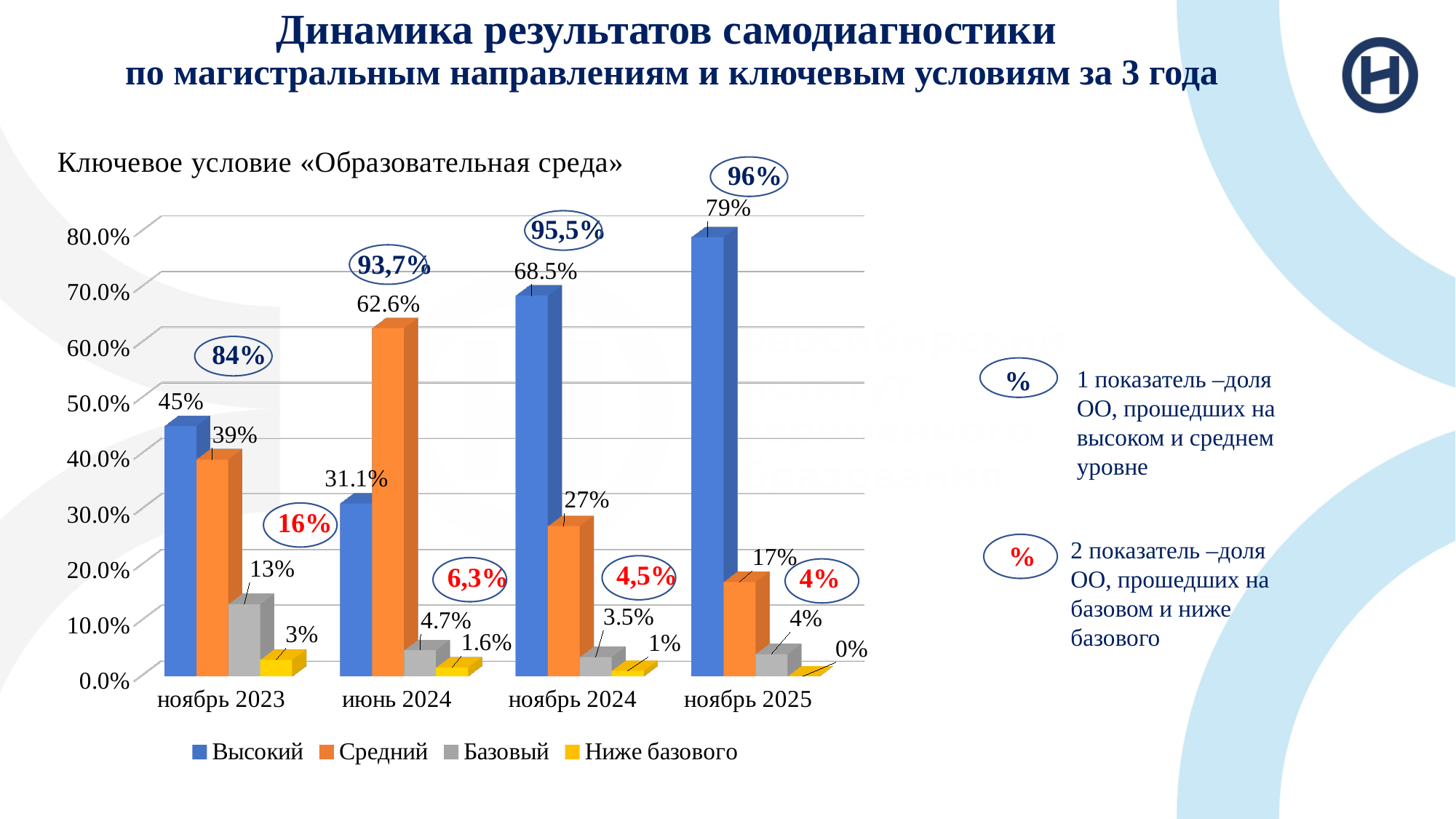
What is the value for Базовый in ноябрь 2023? 13% What is the difference between the Высокий values for ноябрь 2025 and ноябрь 2024? 10.5% How many periods are shown on the x axis? 4 What kind of chart is shown on the slide? Bar chart What is the value for Ниже базового in ноябрь 2024? 1% How many series does the legend list? 4 In which period is the Высокий value the highest? ноябрь 2025 What is the value for Средний in июнь 2024? 62.6% Does the Средний value rise or fall from июнь 2024 to ноябрь 2025? Fall In which period is the Ниже базового value the lowest? ноябрь 2025 Which is larger in июнь 2024: Высокий or Средний? Средний What is the value for Высокий in ноябрь 2025? 79%